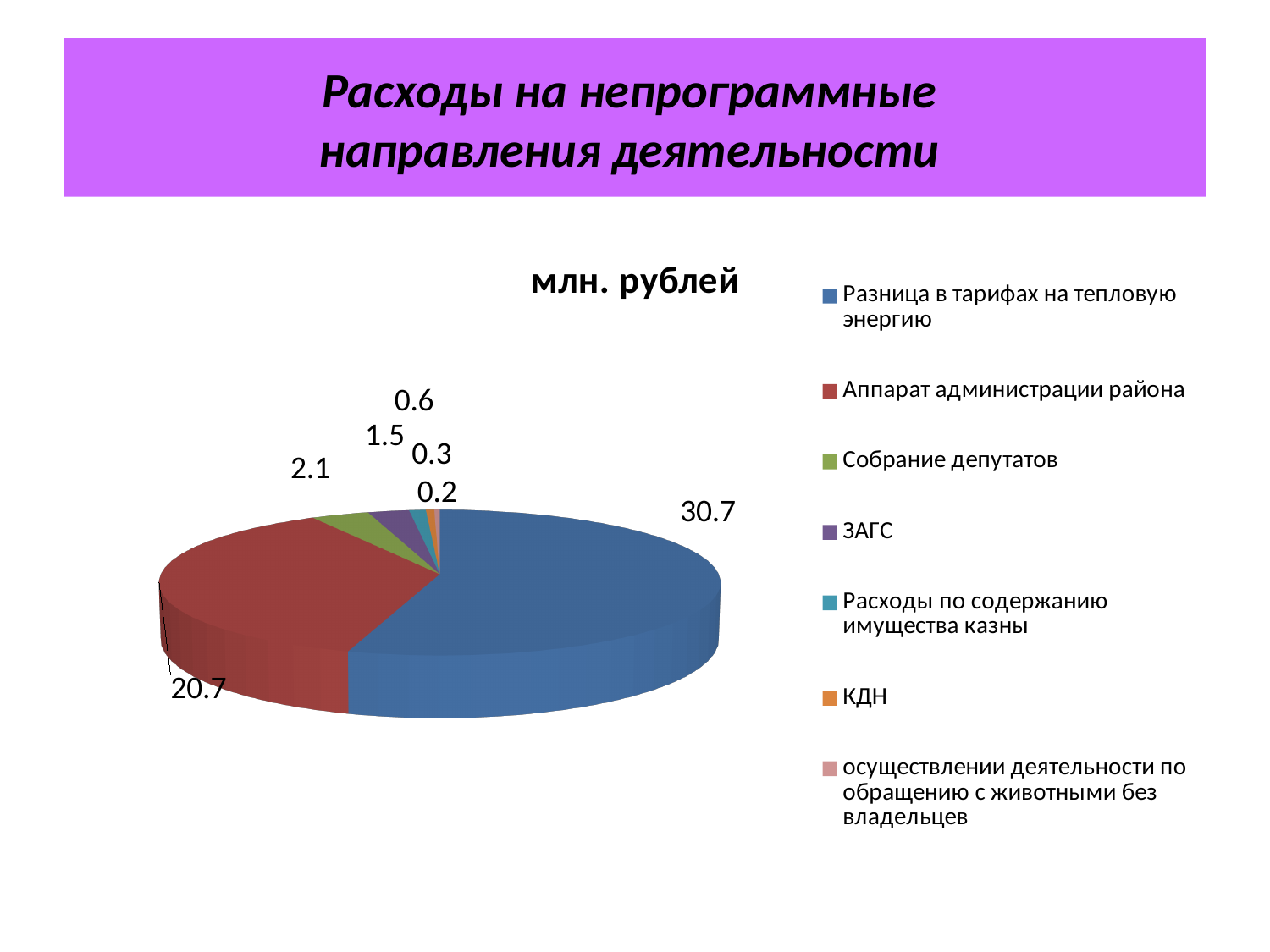
What is the smallest value labelled on the pie chart? 0.2 What colour is the slice for 'Аппарат администрации района'? red Which is larger: the value for 'Собрание депутатов' or the value for 'ЗАГС'? Собрание депутатов Which category has the largest slice of the pie? Разница в тарифах на тепловую энергию How many categories does the legend of the pie chart list? 7 What is the value for 'Собрание депутатов'? 2.1 What is the value for 'ЗАГС'? 1.5 What kind of chart is shown on the slide? pie chart What is the value for 'Аппарат администрации района'? 20.7 What is the difference between the values for 'Разница в тарифах на тепловую энергию' and 'Аппарат администрации района'? 10 What is the title of the chart? млн. рублей What is the value for 'Разница в тарифах на тепловую энергию'? 30.7